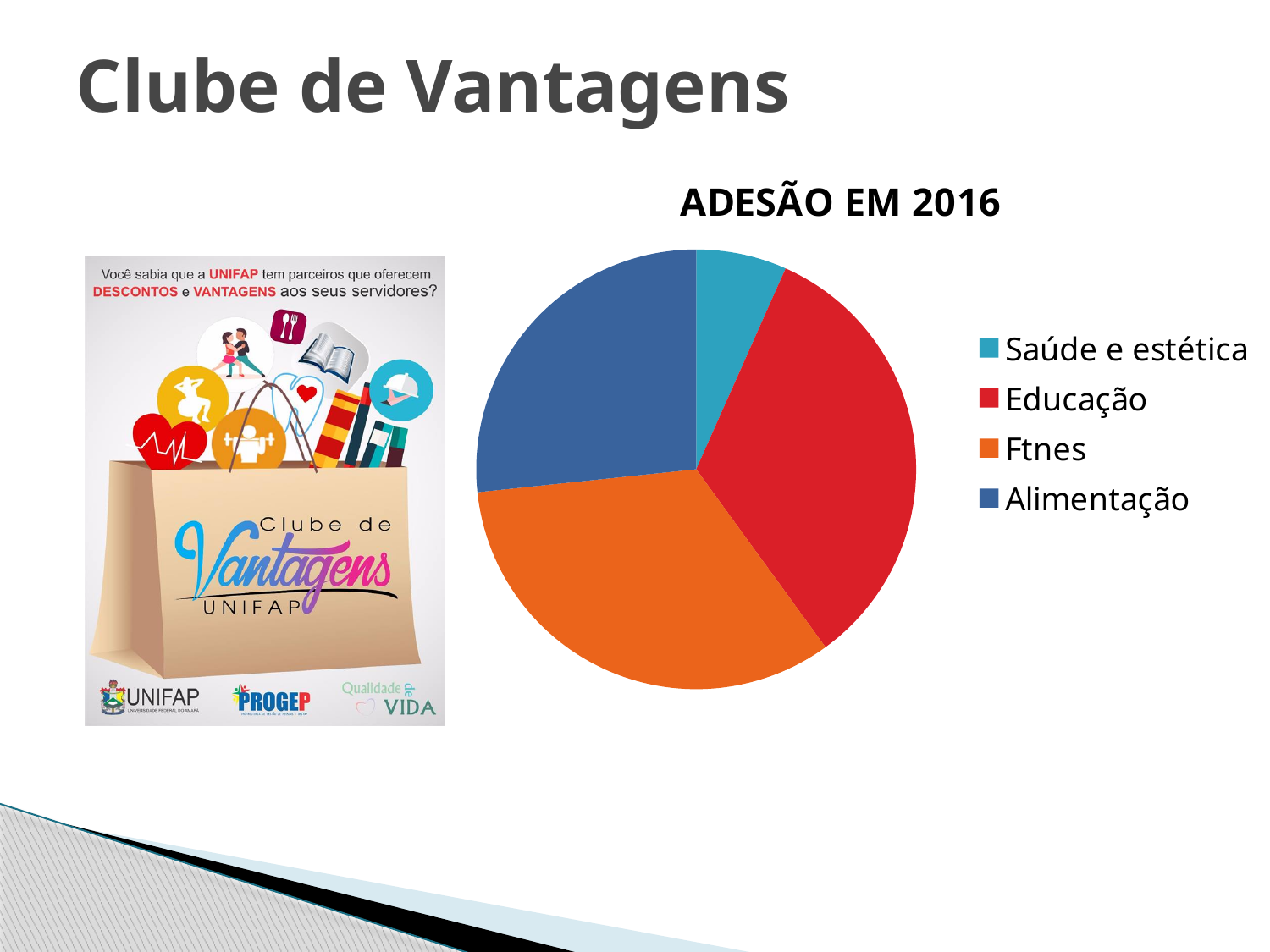
Which slice is larger in the pie chart, Saúde e estética or Educação? Educação Which category has the smallest slice in the pie chart? Saúde e estética How many entries does the legend of the pie chart list? 4 Which slice is larger in the pie chart, Saúde e estética or Alimentação? Alimentação What kind of chart is shown on the slide? pie chart How many slices does the pie chart have? 4 Which slice is larger in the pie chart, Ftnes or Saúde e estética? Ftnes What is the title of the pie chart? ADESÃO EM 2016 Which category is shown in red in the pie chart? Educação